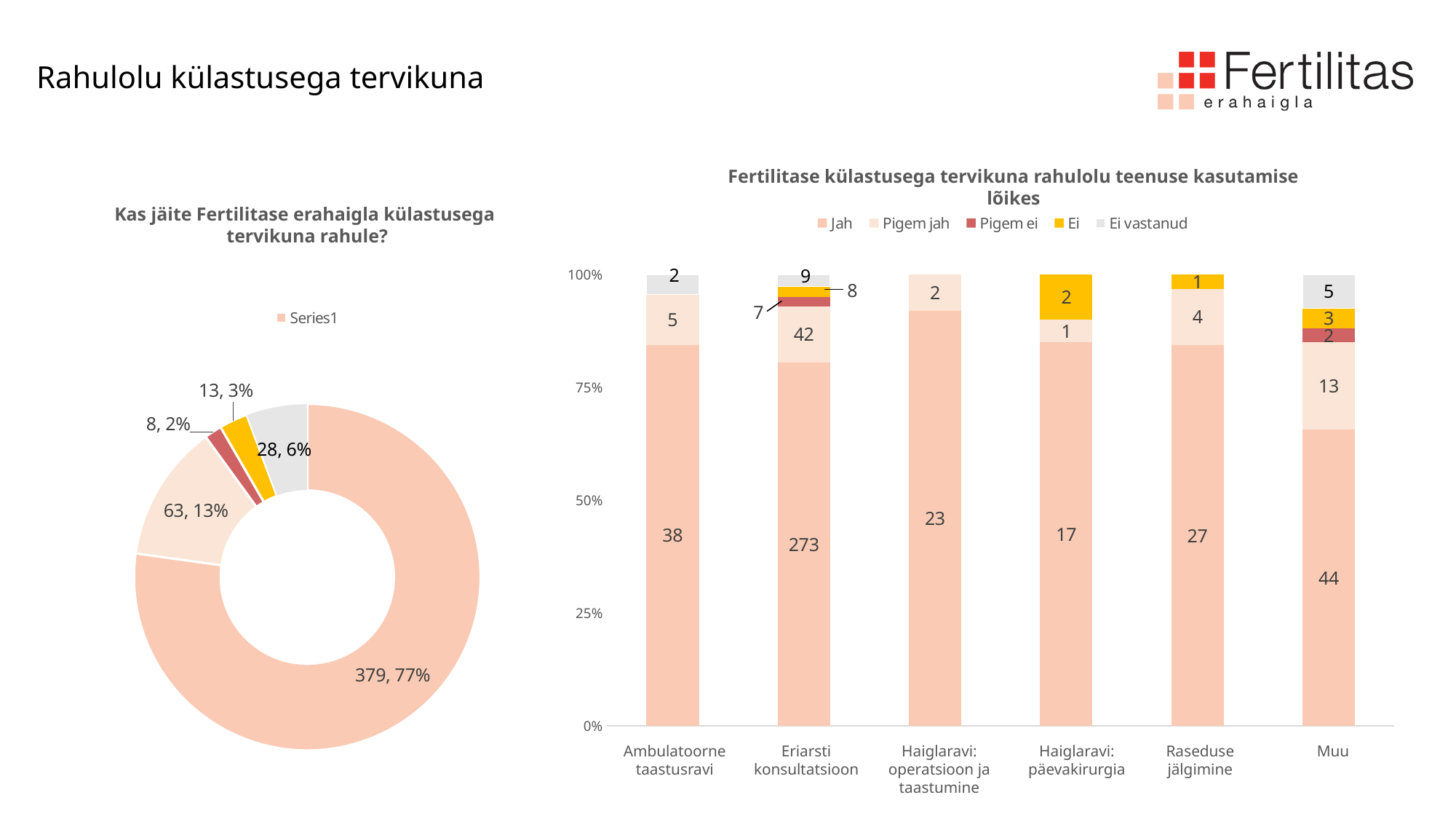
What kind of chart is the right chart "Fertilitase külastusega tervikuna rahulolu teenuse kasutamise lõikes"? Stacked bar chart In the right chart, what is the difference between the Jah value for Muu and the Jah value for Ambulatoorne taastusravi? 6 What kind of chart is the left chart titled "Kas jäite Fertilitase erahaigla külastusega tervikuna rahule?"? Doughnut (pie) chart How many slices does the left doughnut chart have? 5 How many categories are shown on the x axis of the right chart? 6 How many series does the legend of the right chart list? 5 In the left doughnut chart, what is the value and percentage shown on the largest slice? 379, 77% In the right chart, what is the Pigem jah value for Muu? 13 In the right chart, which category has the highest Jah value? Eriarsti konsultatsioon In the right chart, what is the total of all segments in the Muu bar? 67 In the left doughnut chart, what share of the whole does the slice with value 63 represent? 13% In the right chart "Fertilitase külastusega tervikuna rahulolu teenuse kasutamise lõikes", what is the Jah value for Eriarsti konsultatsioon? 273